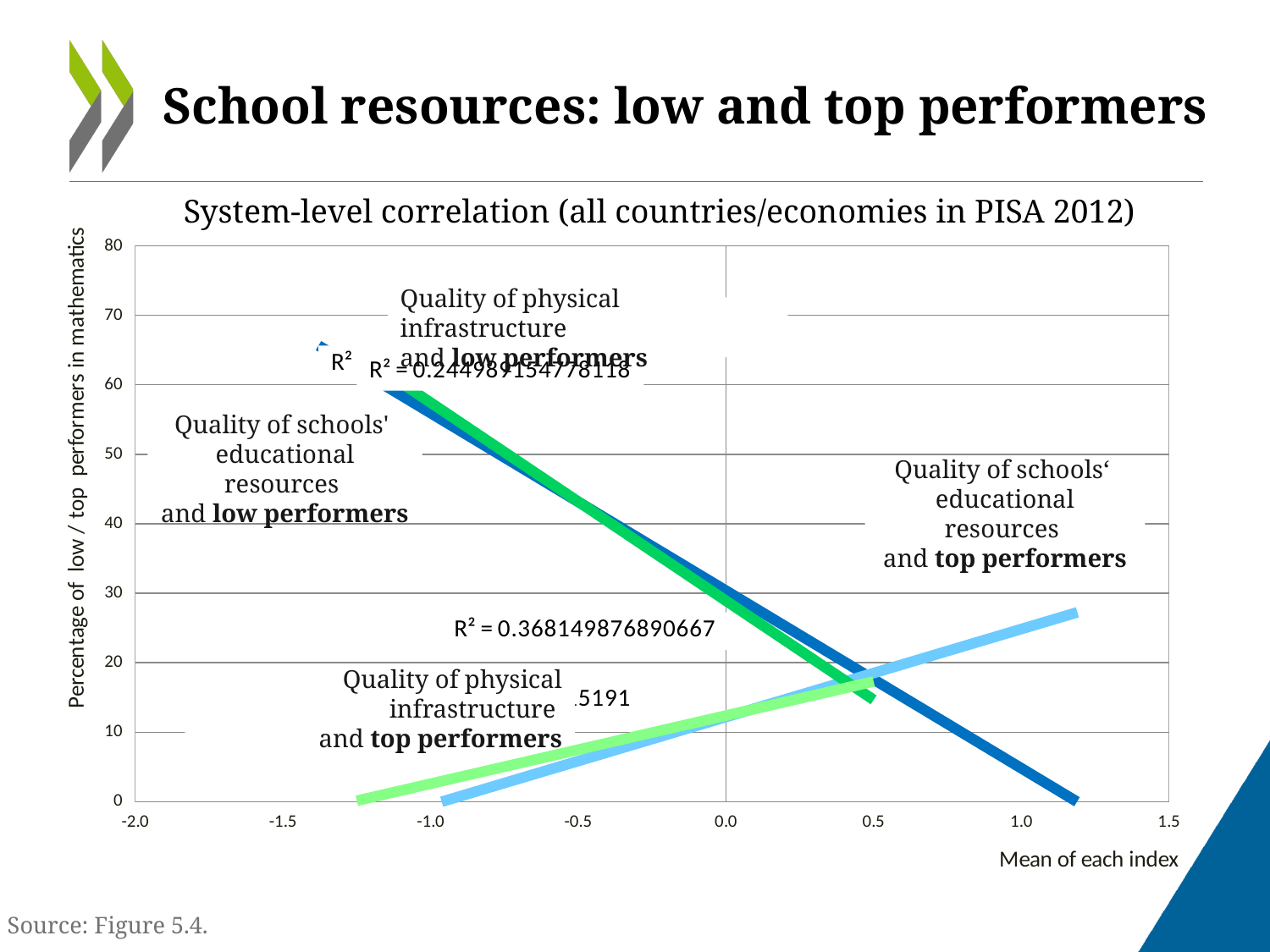
Do the lines for low performers rise or fall as the mean of each index increases? fall At a mean index of 1.0, is the value of the 'Quality of schools' educational resources and low performers' line greater or less than 20? less What is the lowest value shown on the x axis? -2.0 Do the lines for top performers rise or fall as the mean of each index increases? rise What is the highest value shown on the y axis? 80 How many trend lines are plotted on the chart? 4 What is the title of the chart? System-level correlation (all countries/economies in PISA 2012) What R² value is printed in the middle of the chart, below the descending lines? R² = 0.368149876890667 What kind of chart is shown on the slide? line chart What is the label of the x axis? Mean of each index At a mean index of 0.0, which is larger: the value of the low performers lines or the value of the top performers lines? low performers lines At a mean index of 1.0, is the value of the 'Quality of schools' educational resources and top performers' line greater or less than 10? greater